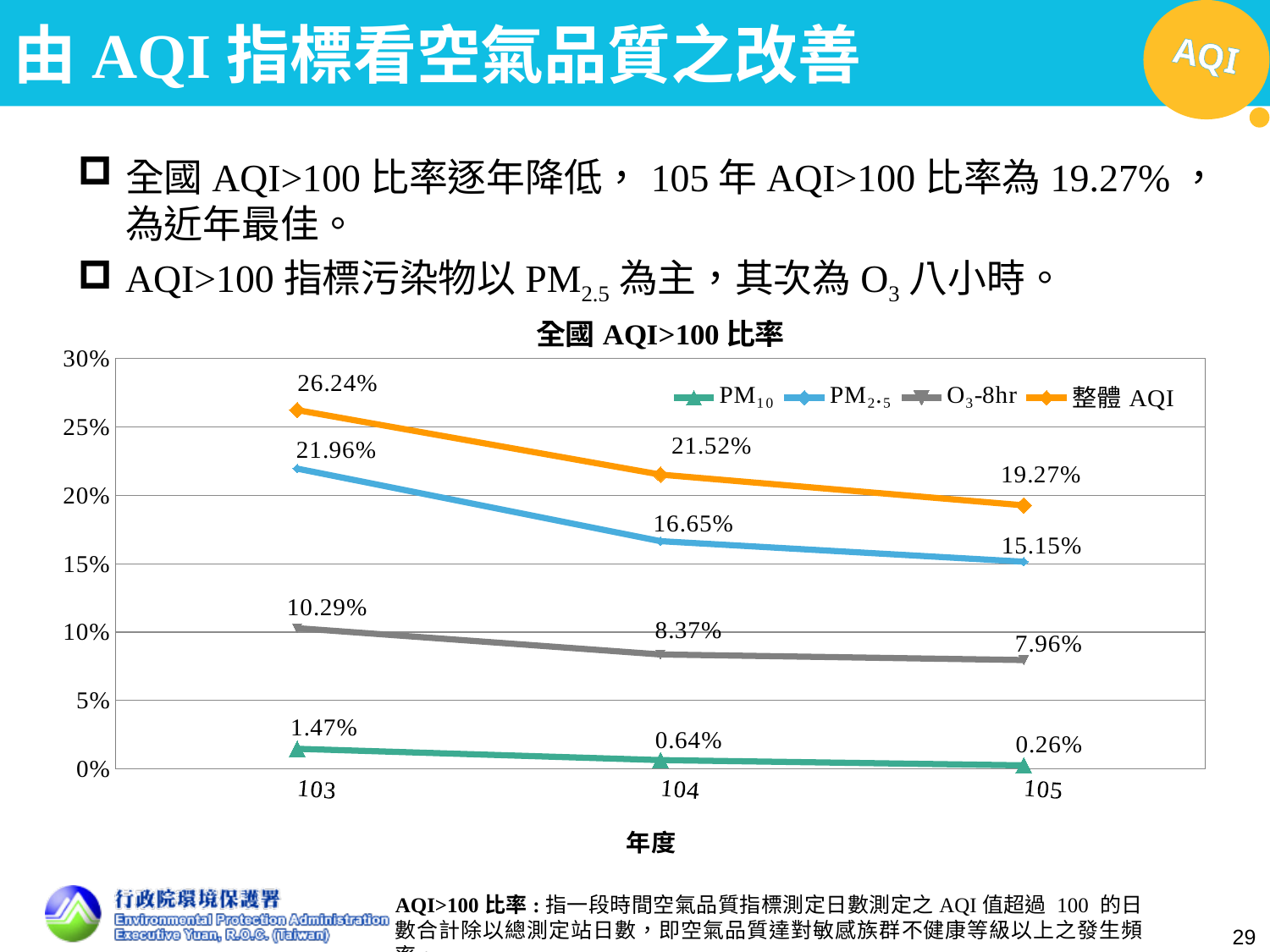
What is the 整體 AQI value for year 105? 19.27% What type of chart is shown on the slide? line chart What is the PM10 value for year 105? 0.26% Which is larger in year 105: the PM2.5 value or the O3-8hr value? PM2.5 Does the PM2.5 series rise or fall from year 103 to year 105? fall What is the difference between the 整體 AQI values for years 103 and 105? 6.97% How many series does the legend list? 4 How many years are shown on the x axis? 3 What is the O3-8hr value for year 103? 10.29% What is the PM2.5 value for year 104? 16.65% In which year is the 整體 AQI value highest? 103 Which series has the lowest value in year 104? PM10